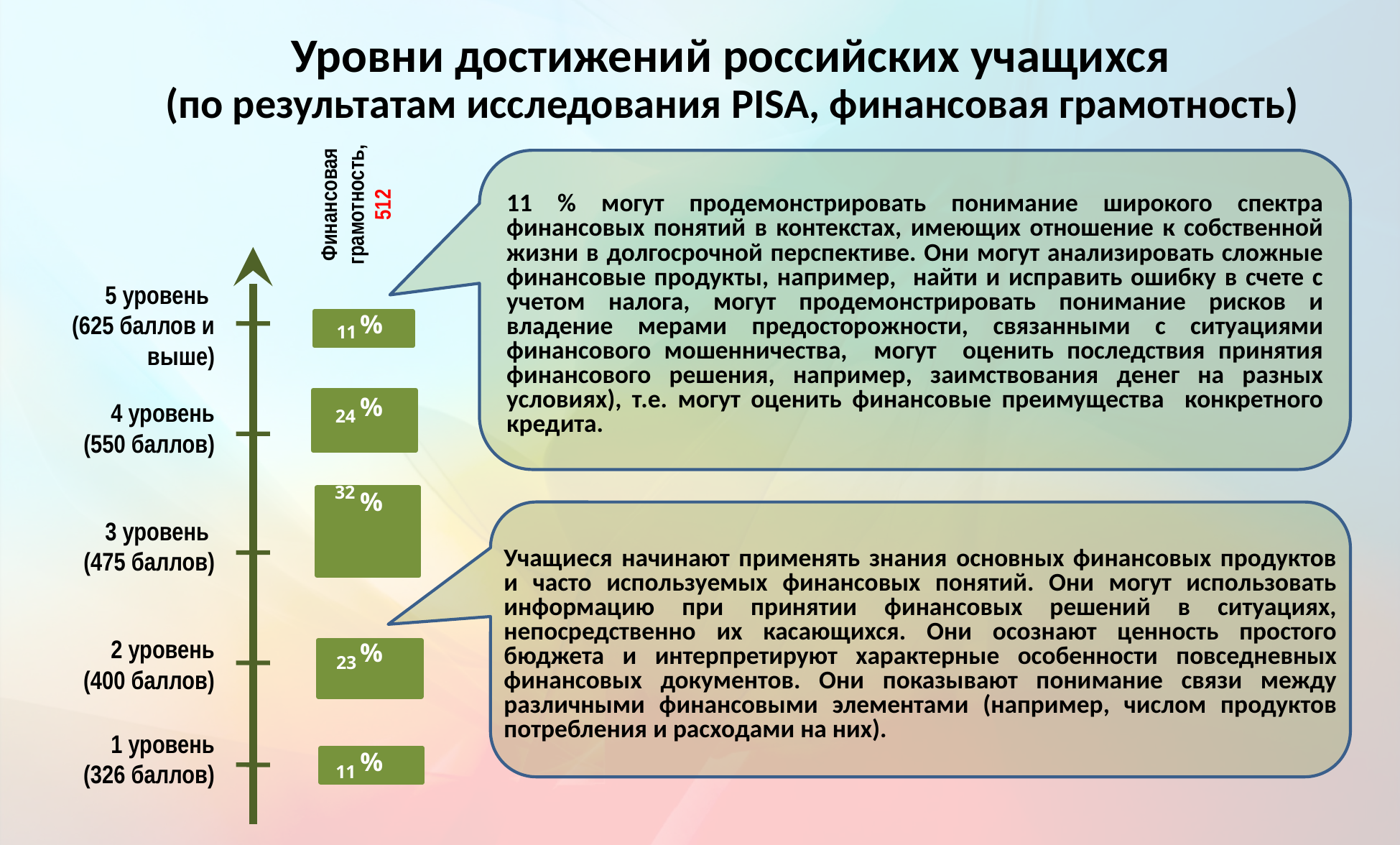
What percentage of students is shown for level 5 (625 баллов и выше)? 11 % What number is printed in red next to the column heading 'Финансовая грамотность'? 512 Which has a larger share of students, level 4 or level 2? 4 уровень What is the difference in percentage points between level 3 and level 4? 8 What kind of chart is used to show the shares of students by level? bar chart What percentage of students is shown for level 2 (400 баллов)? 23 % Which level has the highest share of students? 3 уровень (475 баллов) Do the percentages rise or fall going from level 1 up to level 3? rise How many achievement levels are shown on the chart? 5 What percentage of students is shown for level 4 (550 баллов)? 24 % What percentage of students is shown for level 3 (475 баллов)? 32 % Which levels share the lowest percentage of students? 1 уровень and 5 уровень (11 % each)